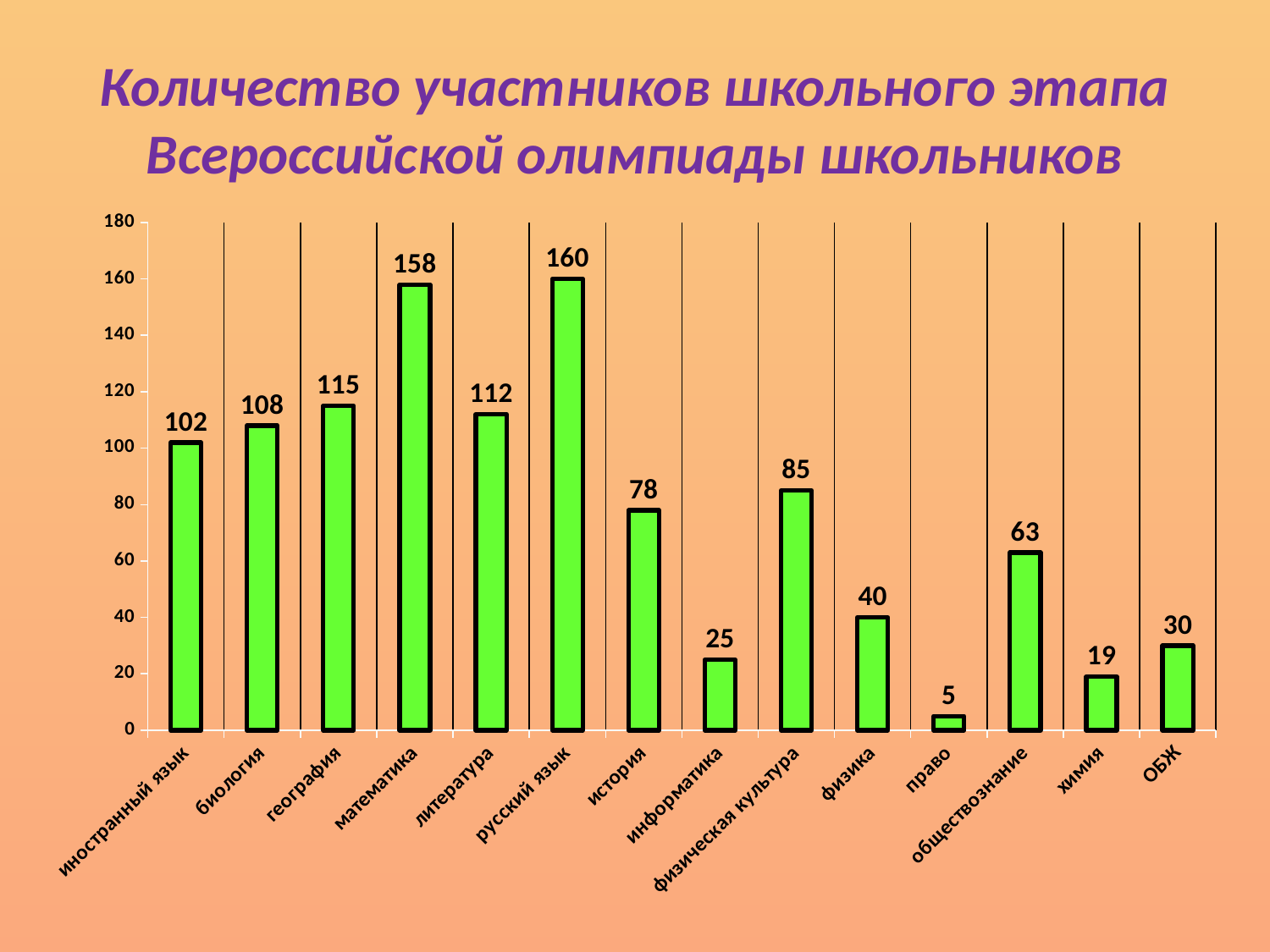
Which is larger, the value for история or the value for физика? история Is the value for литература greater or less than 100? greater Which subject has the lowest number of participants? право How many subjects are shown on the x axis? 14 How many participants are shown for математика? 158 What is the difference between the values for русский язык and математика? 2 What is the difference between the values for география and химия? 96 What is the title of the chart? Количество участников школьного этапа Всероссийской олимпиады школьников What kind of chart is shown on the slide? bar chart What is the value for физическая культура? 85 Which subject has the highest number of participants? русский язык What is the value for обществознание? 63